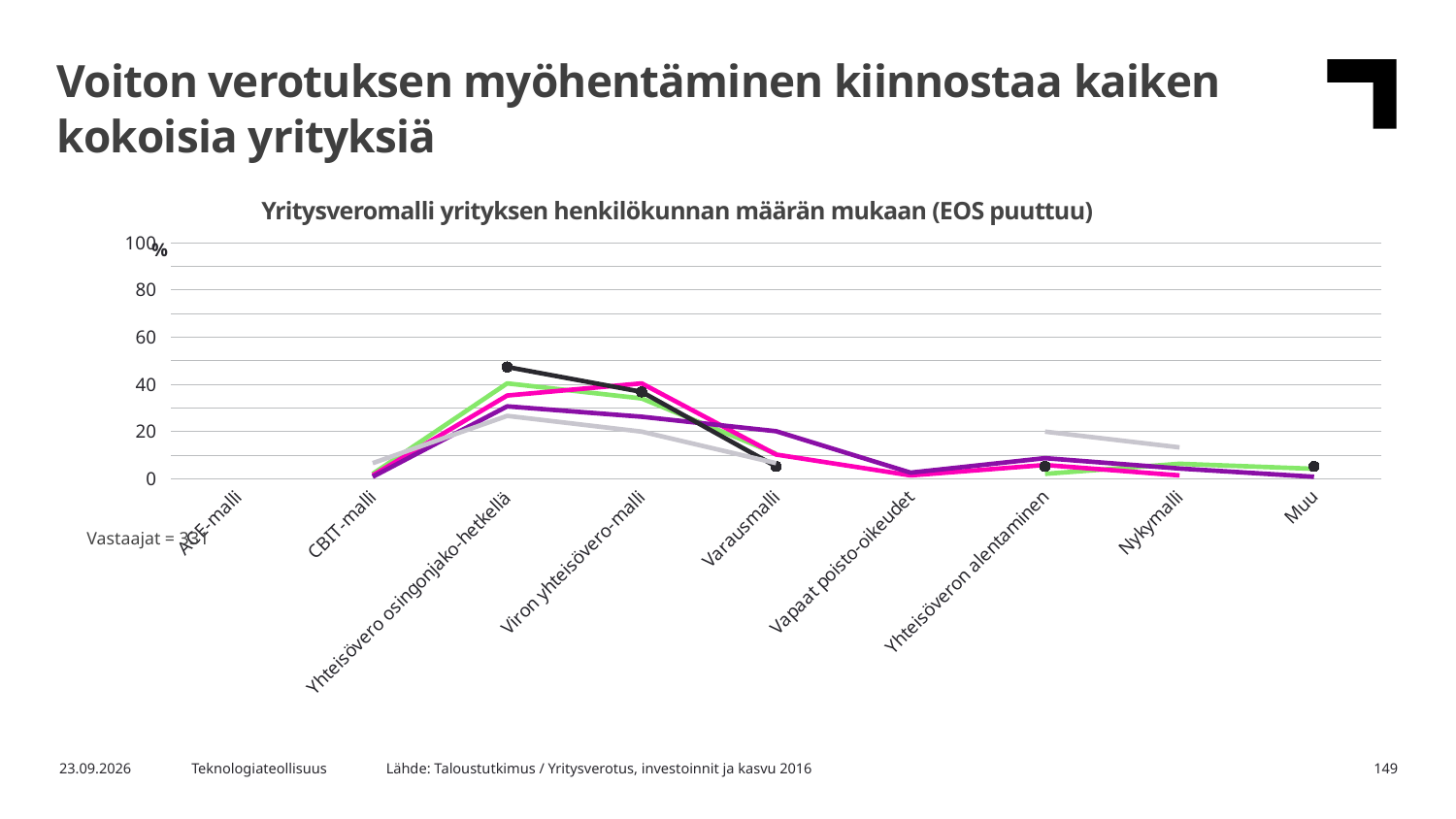
What is the highest value shown on the y axis of the chart? 100 Is the value of the green line for Muu greater or less than 20? less Which is larger for the black line: the value for Yhteisövero osingonjako-hetkellä or the value for Varausmalli? Yhteisövero osingonjako-hetkellä What kind of chart is shown on the slide? line chart Is the value of the magenta line for Viron yhteisövero-malli greater or less than 20? greater How many categories are shown on the x axis of the chart? 9 Which category on the x axis has the highest plotted values across the lines? Yhteisövero osingonjako-hetkellä Is the value of the black line for Varausmalli greater or less than 20? less What is the title of the chart? Yritysveromalli yrityksen henkilökunnan määrän mukaan (EOS puuttuu) Do the plotted values rise or fall between Viron yhteisövero-malli and Varausmalli? fall Do the plotted values rise or fall between CBIT-malli and Yhteisövero osingonjako-hetkellä? rise